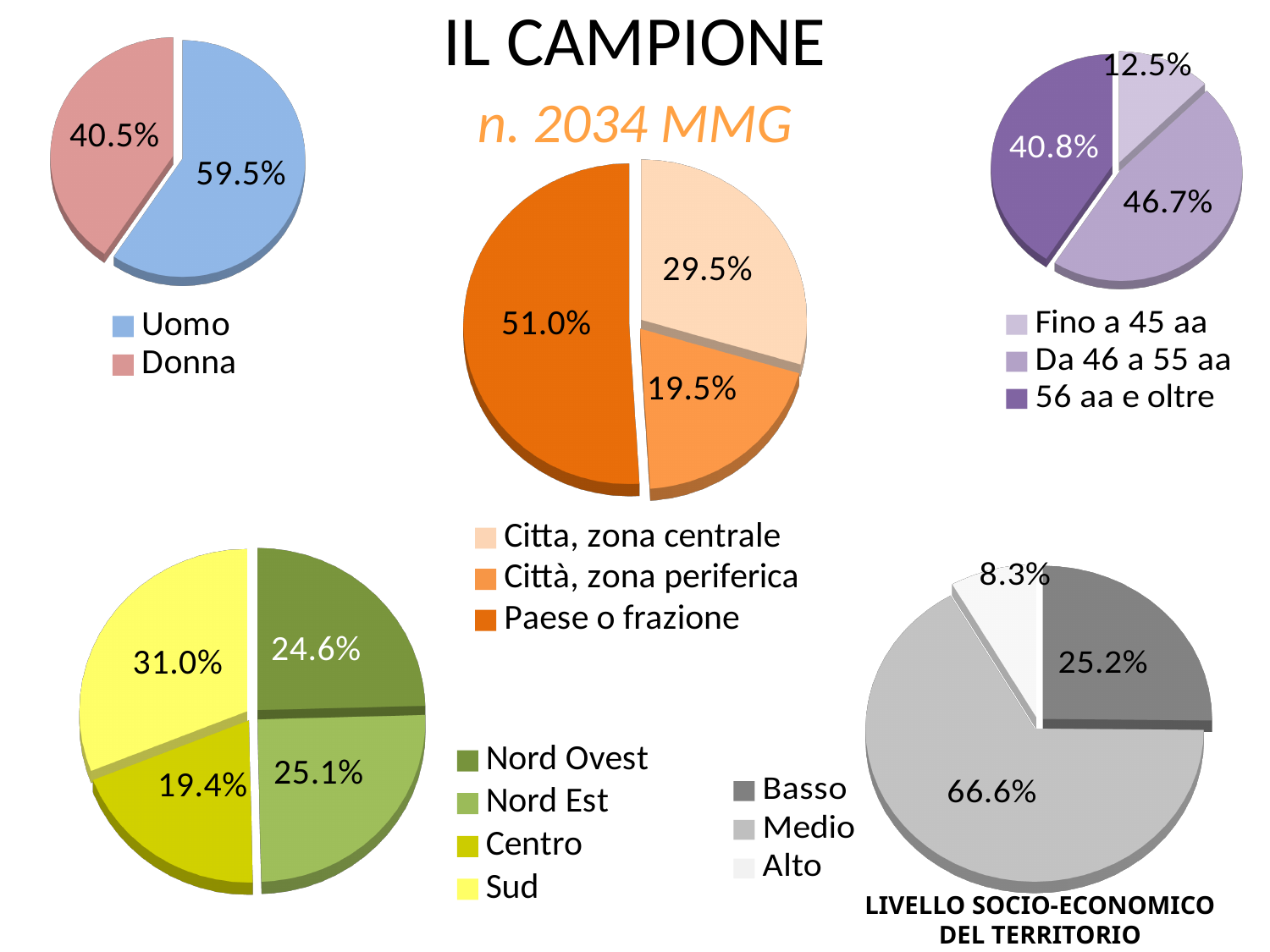
In the top-right pie chart, which category has the smallest share? Fino a 45 aa In the top-right pie chart, what share corresponds to 'Da 46 a 55 aa'? 46.7% In the central pie chart, what is the difference between the shares for 'Città, zona centrale' and 'Città, zona periferica'? 10.0% In the chart titled 'LIVELLO SOCIO-ECONOMICO DEL TERRITORIO', what share corresponds to Medio? 66.6% What kind of chart is the top-left chart? Pie chart In the top-left pie chart, what share is labelled Donna? 40.5% In the chart titled 'LIVELLO SOCIO-ECONOMICO DEL TERRITORIO', which is larger, Basso or Alto? Basso In the bottom-left pie chart, which region has the largest share? Sud In the bottom-left pie chart, how many categories does the legend list? 4